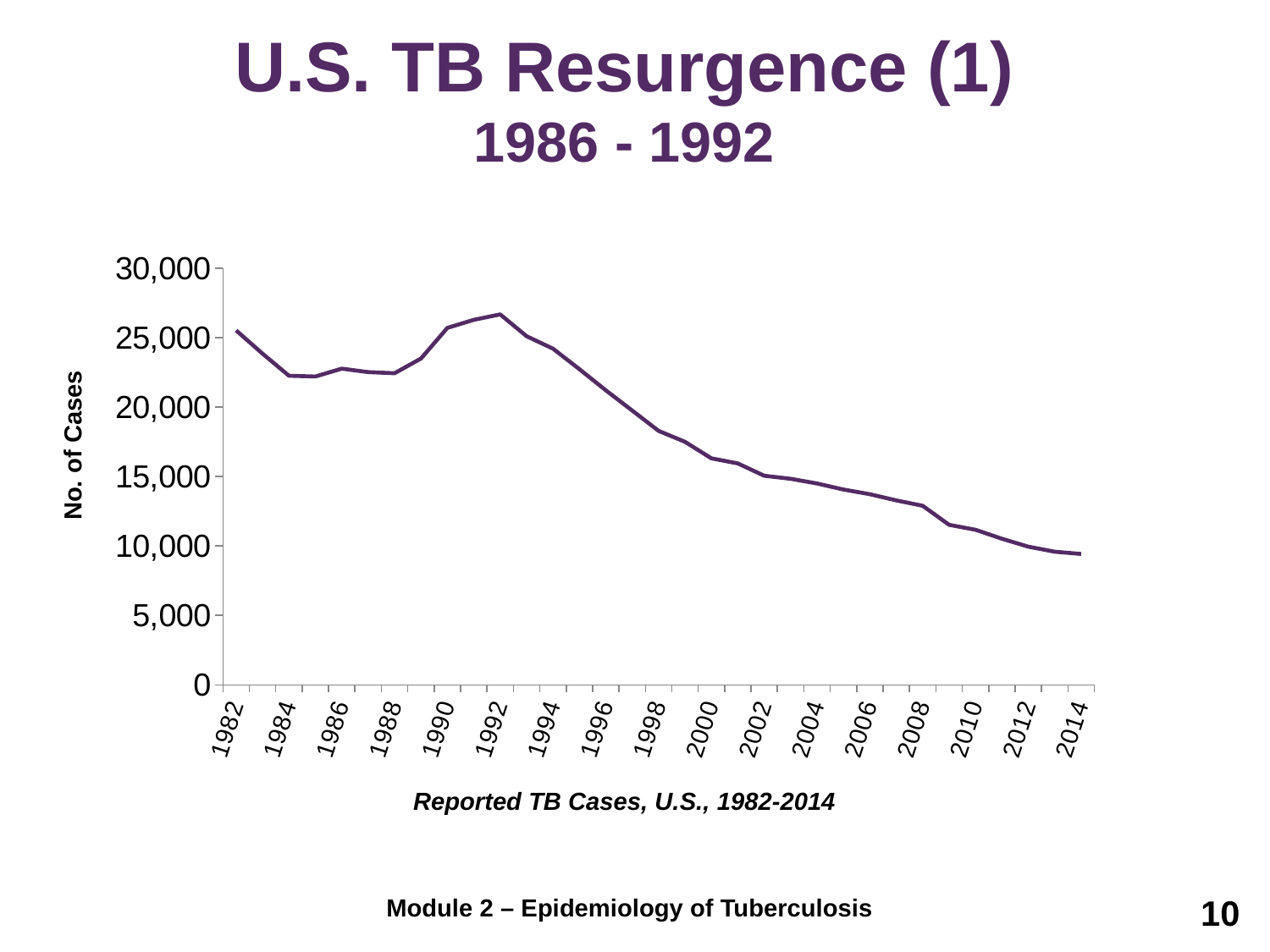
Is the number of cases in 2014 greater or less than 10,000? less What is the title printed below the chart? Reported TB Cases, U.S., 1982-2014 Is the number of cases in 1998 greater or less than 20,000? less Is the number of cases in 1986 greater or less than 20,000? greater Which year has more reported cases, 1982 or 2000? 1982 In which year shown on the x axis is the number of cases lowest? 2014 Do the number of cases rise or fall between 1992 and 2014? fall In which year shown on the x axis does the number of cases reach its highest point? 1992 How many year labels are shown on the x axis? 17 What is the label on the vertical axis of the chart? No. of Cases What kind of chart is shown on the slide? Line chart